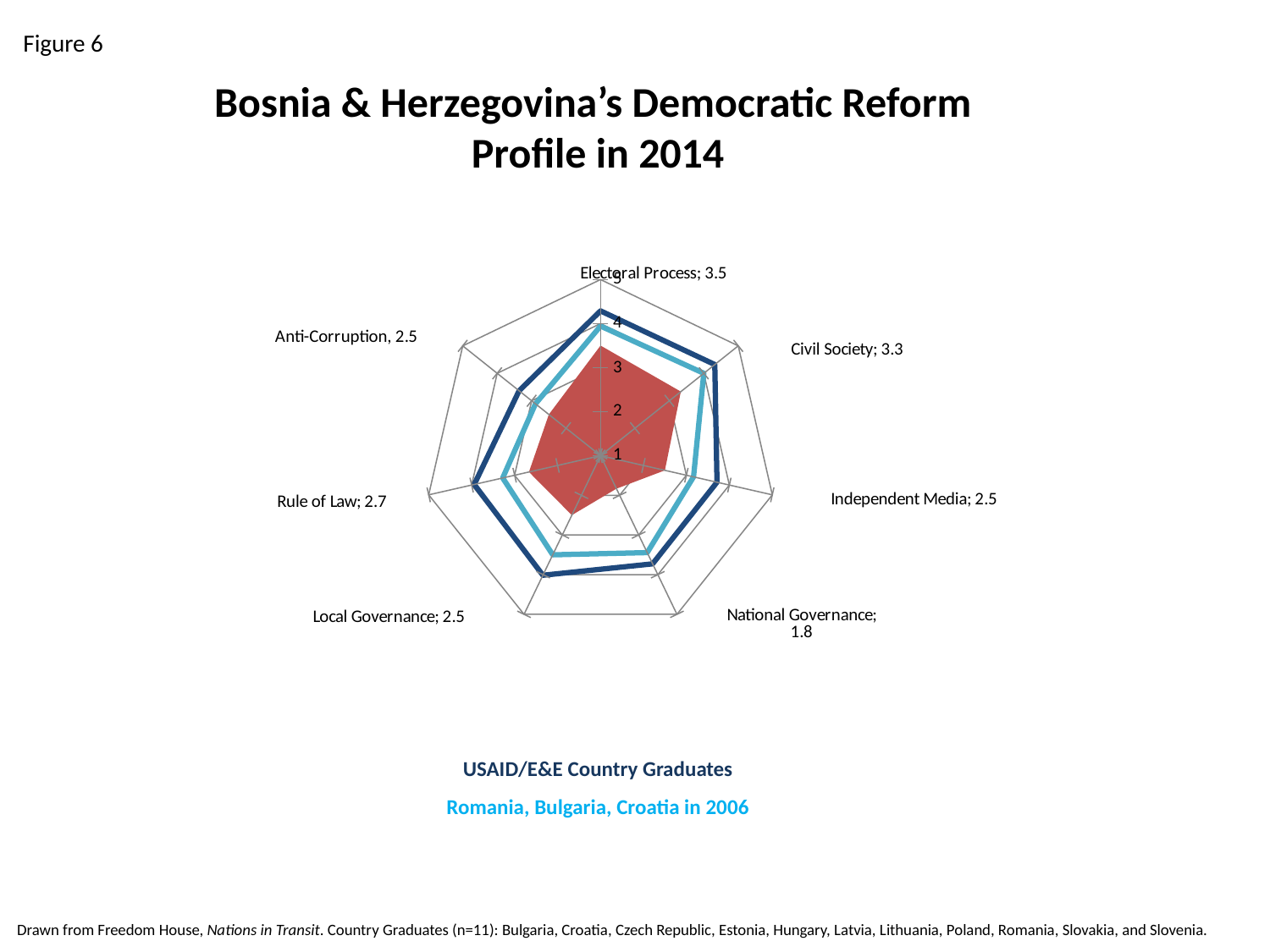
In which category does Bosnia & Herzegovina have its highest score? Electoral Process What is Bosnia & Herzegovina's score for Rule of Law? 2.7 What kind of chart is shown on the slide? Radar chart In which category does Bosnia & Herzegovina have its lowest score? National Governance Which is higher for Bosnia & Herzegovina: Civil Society or Rule of Law? Civil Society Which series is drawn in dark blue on the chart? USAID/E&E Country Graduates What is Bosnia & Herzegovina's score for Civil Society? 3.3 What is the difference between Bosnia & Herzegovina's Electoral Process score and its National Governance score? 1.7 What is Bosnia & Herzegovina's score for Electoral Process? 3.5 What is Bosnia & Herzegovina's score for National Governance? 1.8 How many categories are plotted on the radar chart? 7 Is the USAID/E&E Country Graduates value for Electoral Process greater or less than 4? greater